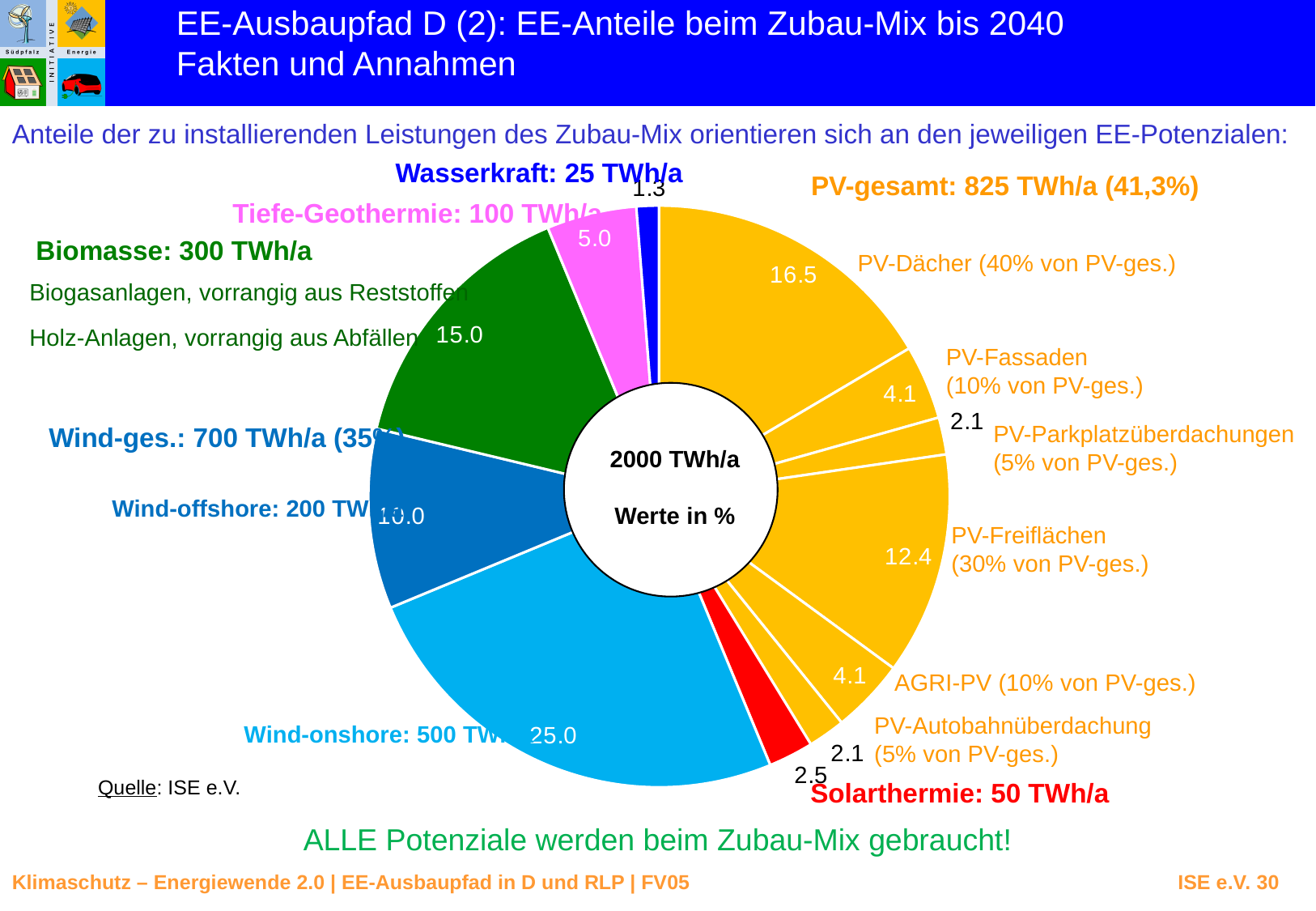
What percentage value is shown for the Wasserkraft slice? 1.3 Which slice of the pie chart has the largest value? Wind-onshore What percentage value is shown for the PV-Dächer slice? 16.5 What is the difference between the Wind-onshore value and the Wind-offshore value? 15.0 What percentage value is shown for the Biomasse slice? 15.0 Which is larger, the PV-Freiflächen slice or the Biomasse slice? Biomasse What percentage value is shown for the Solarthermie slice? 2.5 What total amount is written in the centre of the pie chart? 2000 TWh/a Which slice of the pie chart has the smallest value? Wasserkraft What percentage value is shown for the Wind-onshore slice? 25.0 How many slices does the pie chart have? 12 What type of chart is shown on the slide? pie chart